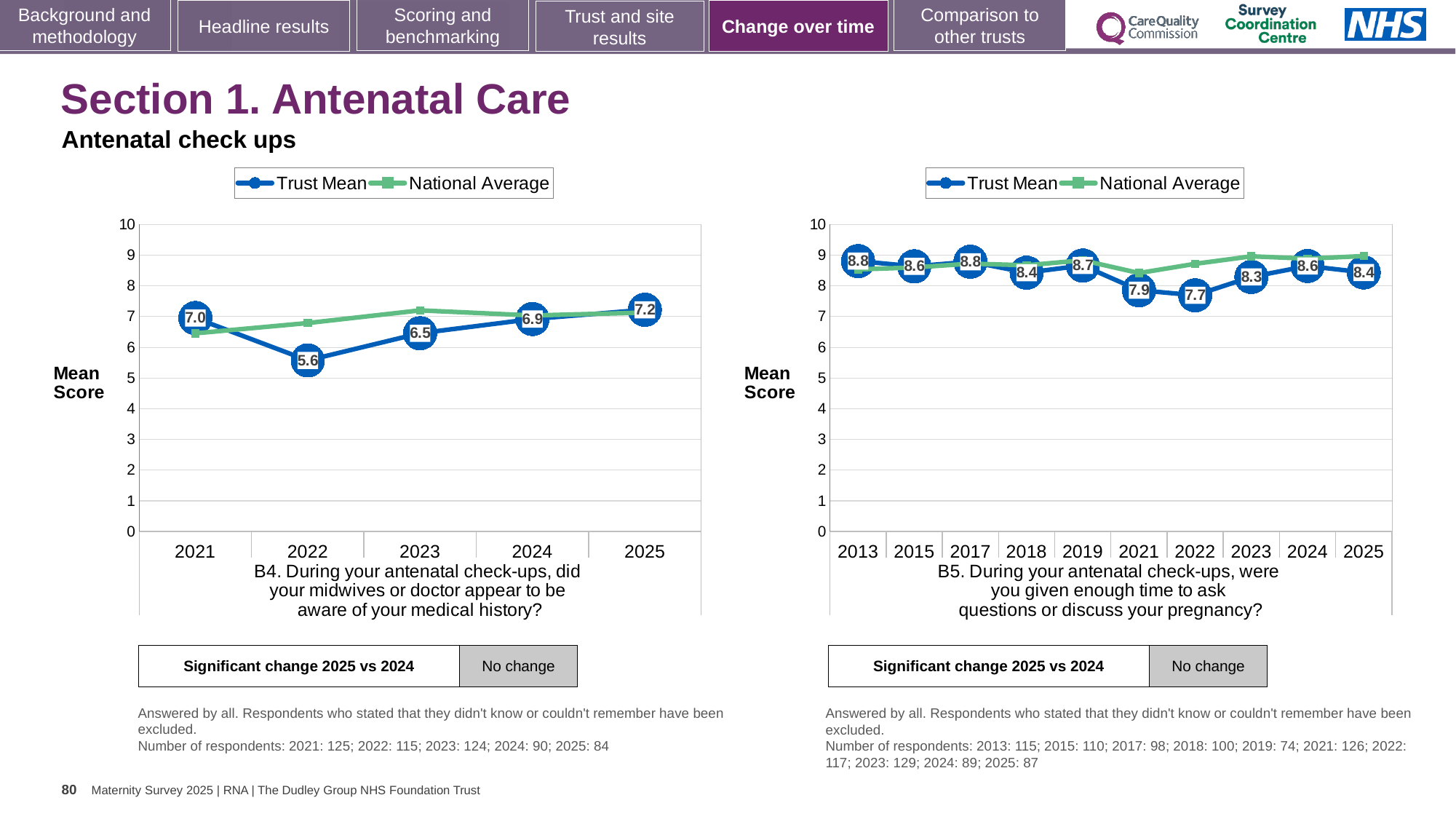
In the right chart (B5), what is the Trust Mean score for 2019? 8.7 In the left chart (B4), which year has the lowest Trust Mean score? 2022 What kind of chart is the right chart (B5)? Line chart In the right chart (B5), how many years are shown on the x axis? 10 In the left chart (B4), what is the difference between the Trust Mean scores for 2025 and 2022? 1.6 In the left chart (B4), which year has the highest Trust Mean score? 2025 In the left chart (B4), what is the Trust Mean score for 2022? 5.6 In the right chart (B5), is the Trust Mean score for 2024 larger or smaller than the Trust Mean score for 2025? larger In the right chart (B5), what is the difference between the Trust Mean scores for 2013 and 2022? 1.1 How many series does the legend of the left chart (B4) list? 2 In the left chart (B4), how many years are shown on the x axis? 5 In the right chart (B5), which year has the lowest Trust Mean score? 2022